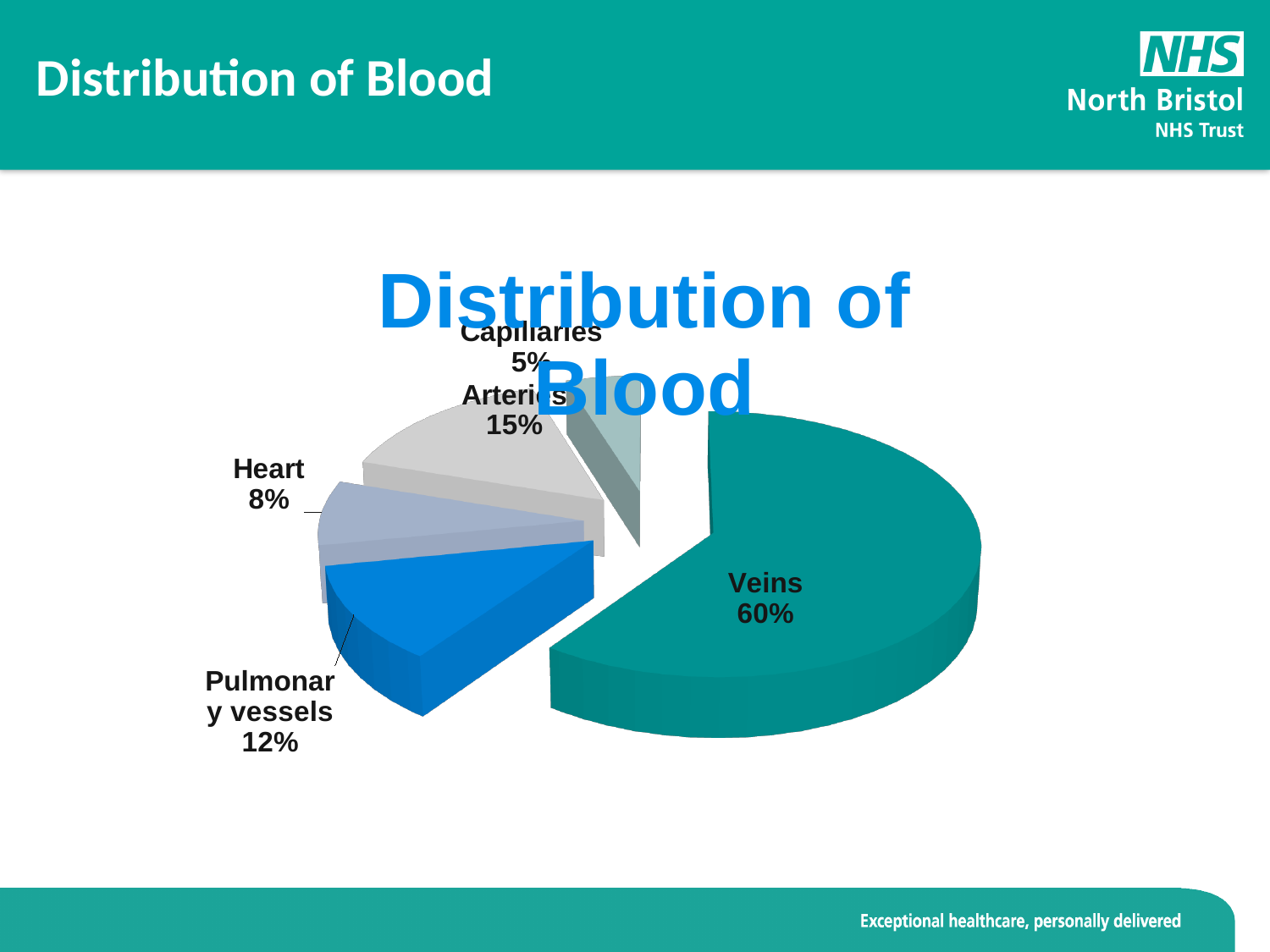
What percentage of blood is in the veins? 60% Which holds a larger share of blood, the heart or the pulmonary vessels? Pulmonary vessels What percentage of blood is in the arteries? 15% Which category holds the smallest share of blood? Capillaries What percentage of blood is in the capillaries? 5% What kind of chart is shown on the slide? Pie chart What percentage of blood is in the pulmonary vessels? 12% What is the title of the chart? Distribution of Blood What is the difference in percentage points between the veins and the arteries? 45 What percentage of blood is in the heart? 8% Which category holds the largest share of blood? Veins How many slices does the pie chart have? 5